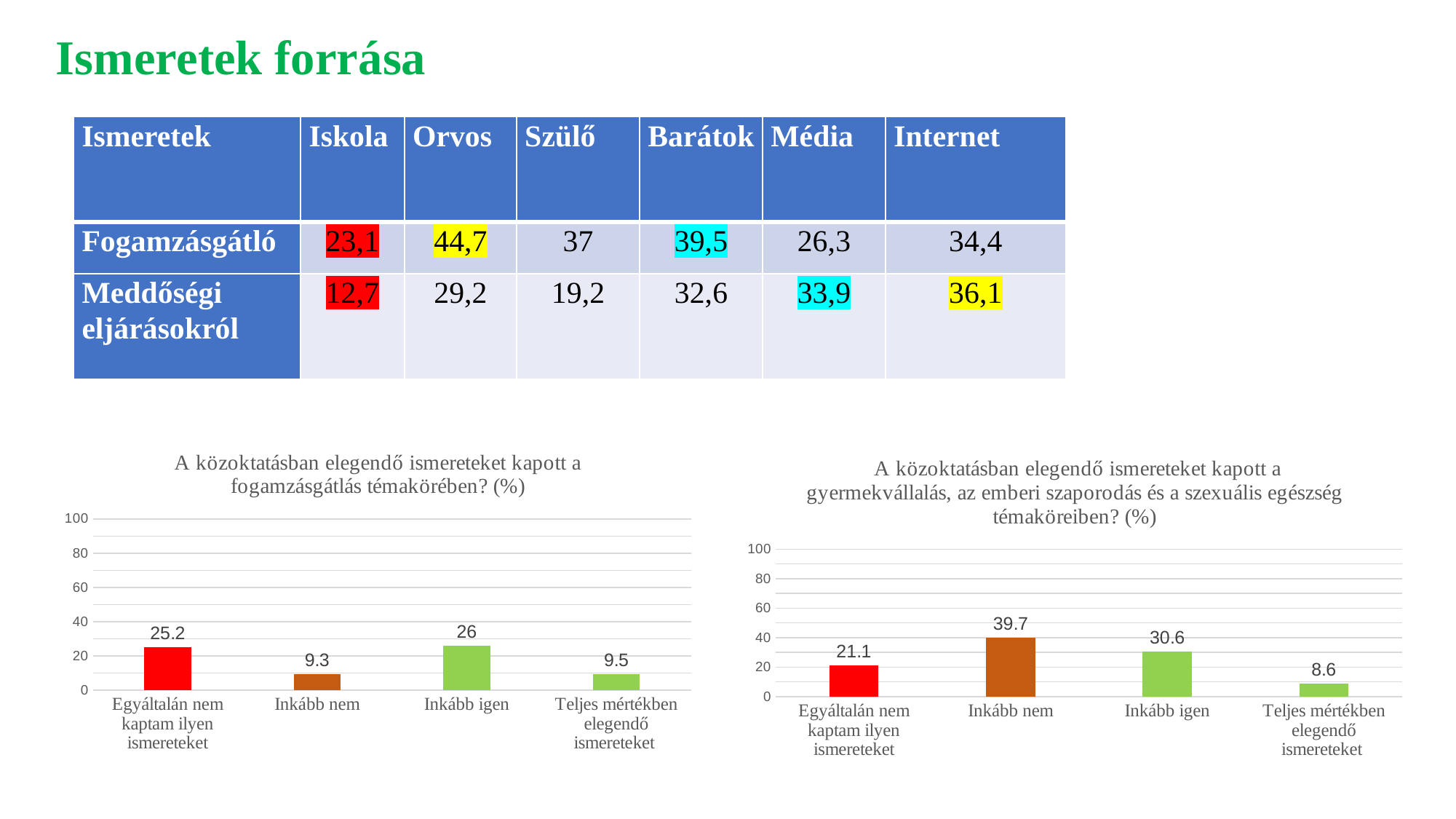
In the right chart (gyermekvállalás, az emberi szaporodás és a szexuális egészség témaköreiben), which category has the highest value? Inkább nem In the right chart (gyermekvállalás, az emberi szaporodás és a szexuális egészség témaköreiben), what is the difference between the values for "Inkább nem" and "Inkább igen"? 9.1 In the right chart (gyermekvállalás, az emberi szaporodás és a szexuális egészség témaköreiben), which category has the lowest value? Teljes mértékben elegendő ismereteket In the left chart (fogamzásgátlás témakörében), what is the difference between the values for "Inkább igen" and "Teljes mértékben elegendő ismereteket"? 16.5 How many categories are shown on the x axis of the left chart (fogamzásgátlás témakörében)? 4 In the right chart (gyermekvállalás, az emberi szaporodás és a szexuális egészség témaköreiben), what is the value for "Inkább nem"? 39.7 In the right chart (gyermekvállalás, az emberi szaporodás és a szexuális egészség témaköreiben), is the value for "Inkább igen" greater or less than 20? greater What kind of chart is the right chart (gyermekvállalás, az emberi szaporodás és a szexuális egészség témaköreiben)? bar chart In the left chart (fogamzásgátlás témakörében), what is the value for "Inkább nem"? 9.3 In the left chart (fogamzásgátlás témakörében), which is larger: the value for "Egyáltalán nem kaptam ilyen ismereteket" or the value for "Inkább nem"? Egyáltalán nem kaptam ilyen ismereteket In the right chart (gyermekvállalás, az emberi szaporodás és a szexuális egészség témaköreiben), what is the value for "Teljes mértékben elegendő ismereteket"? 8.6 In the left chart (fogamzásgátlás témakörében), what is the value for "Egyáltalán nem kaptam ilyen ismereteket"? 25.2